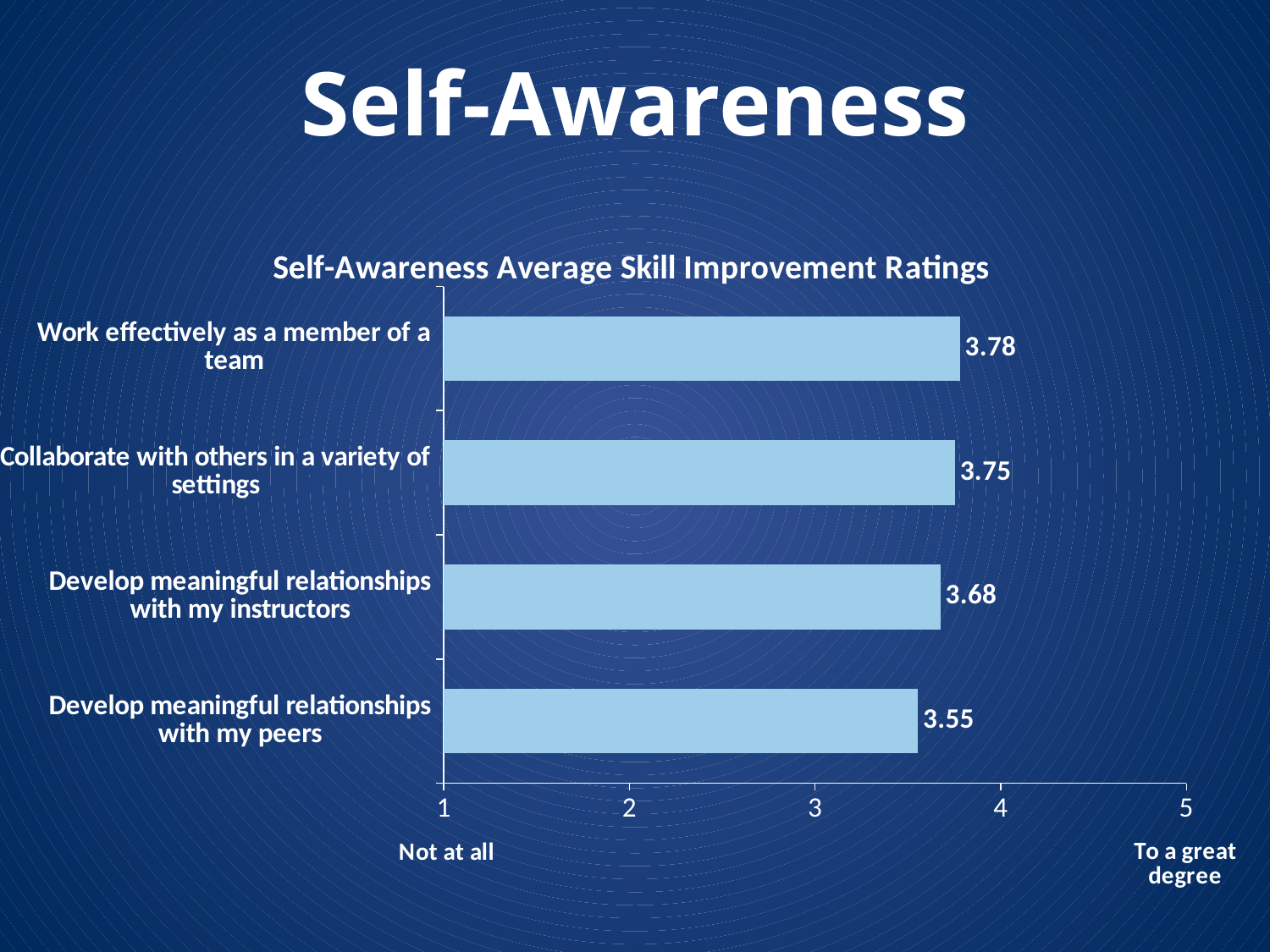
What label appears at the left end of the x axis, under the value 1? Not at all What is the difference between the ratings for 'Work effectively as a member of a team' and 'Develop meaningful relationships with my peers'? 0.23 Which category has the lowest rating? Develop meaningful relationships with my peers What is the average skill improvement rating for 'Work effectively as a member of a team'? 3.78 What is the rating for 'Develop meaningful relationships with my peers'? 3.55 Is the rating for 'Develop meaningful relationships with my instructors' greater or less than 4? less Which category has the highest rating? Work effectively as a member of a team What is the title of the chart? Self-Awareness Average Skill Improvement Ratings Which has a higher rating: 'Develop meaningful relationships with my instructors' or 'Develop meaningful relationships with my peers'? Develop meaningful relationships with my instructors What is the rating for 'Collaborate with others in a variety of settings'? 3.75 How many categories are shown in the chart? 4 What type of chart is shown on the slide? Bar chart